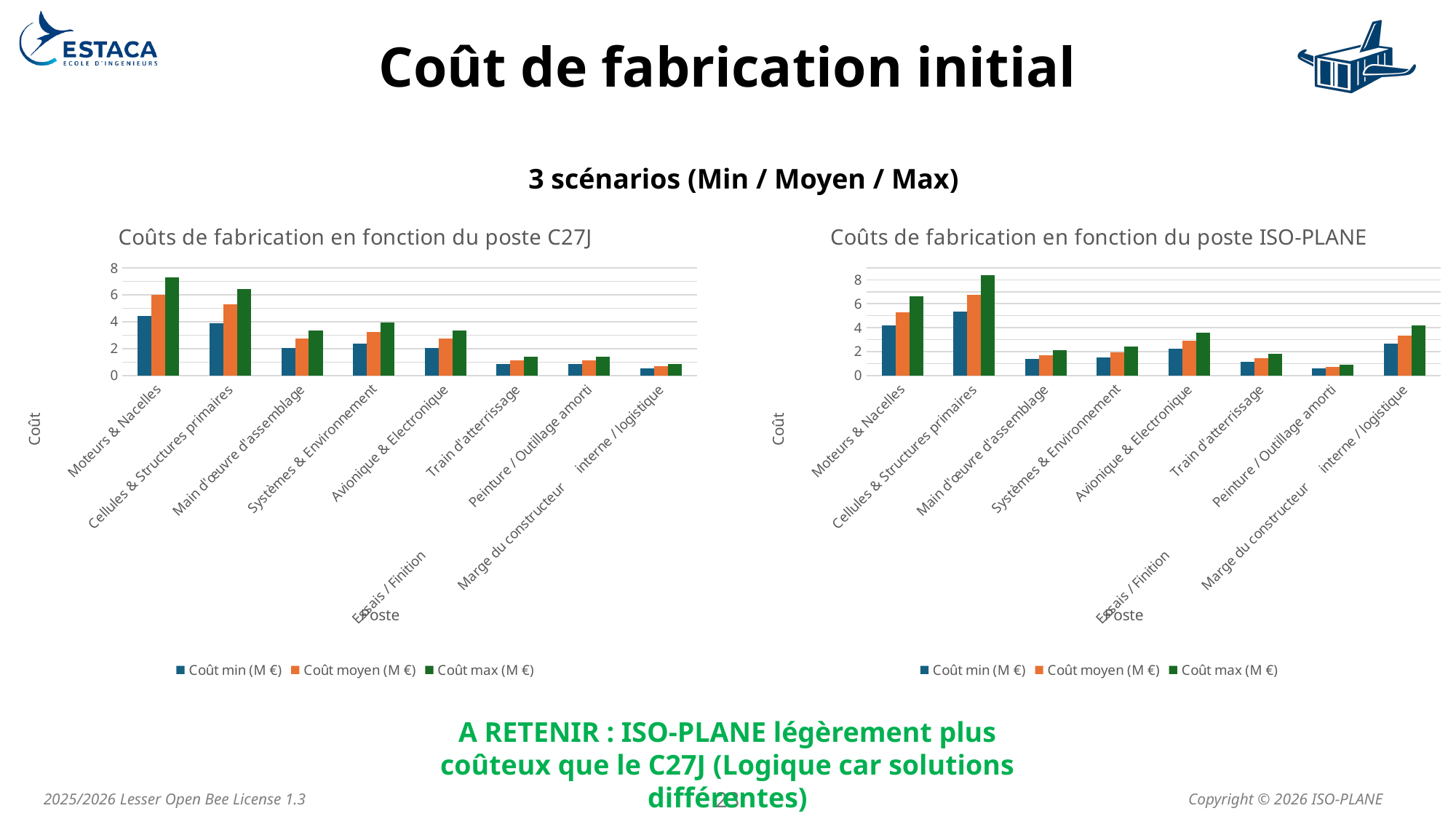
How many categories (postes) are shown on the x axis of the left chart, 'Coûts de fabrication en fonction du poste C27J'? 8 In the left chart, 'Coûts de fabrication en fonction du poste C27J', which is larger: the Coût max (M €) for Moteurs & Nacelles or for Cellules & Structures primaires? Moteurs & Nacelles What are the three legend entries of the left chart, 'Coûts de fabrication en fonction du poste C27J'? Coût min (M €), Coût moyen (M €), Coût max (M €) In the right chart, 'Coûts de fabrication en fonction du poste ISO-PLANE', which is larger: the Coût max (M €) for Cellules & Structures primaires or for Moteurs & Nacelles? Cellules & Structures primaires In the right chart, 'Coûts de fabrication en fonction du poste ISO-PLANE', which poste has the highest Coût max (M €)? Cellules & Structures primaires What kind of chart is the left chart, 'Coûts de fabrication en fonction du poste C27J'? bar chart In the left chart, 'Coûts de fabrication en fonction du poste C27J', which poste has the highest Coût max (M €)? Moteurs & Nacelles How many series does the legend of the right chart, 'Coûts de fabrication en fonction du poste ISO-PLANE', list? 3 In the left chart, 'Coûts de fabrication en fonction du poste C27J', is the Coût min (M €) for Train d'atterrissage greater or less than 2? less In the right chart, 'Coûts de fabrication en fonction du poste ISO-PLANE', which poste has the lowest Coût min (M €)? Peinture / Outillage amorti In the left chart, 'Coûts de fabrication en fonction du poste C27J', is the Coût max (M €) for Moteurs & Nacelles greater or less than 6? greater In the right chart, 'Coûts de fabrication en fonction du poste ISO-PLANE', is the Coût max (M €) for Cellules & Structures primaires greater or less than 8? greater